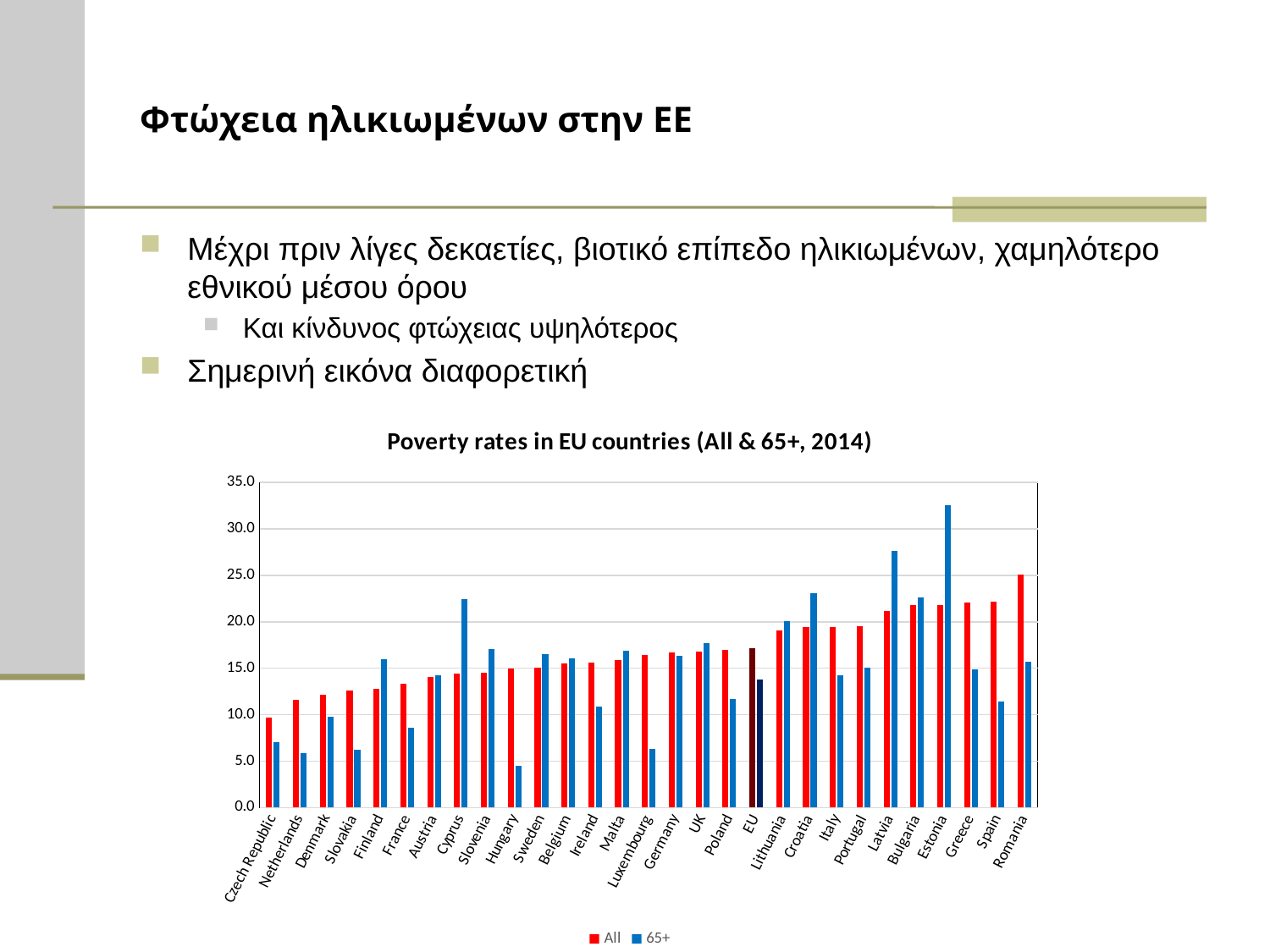
Which country has the lowest 65+ poverty rate? Hungary How many series does the legend list? 2 Is the 65+ value for Hungary greater or less than 5.0? less Do the values of the All series rise or fall from left to right along the x axis? rise Which country has the highest poverty rate for the All series? Romania Which country has the lowest poverty rate for the All series? Czech Republic How many countries/categories are shown on the x axis? 29 For Spain, which is larger: the All value or the 65+ value? All Is the 65+ value for Estonia greater or less than 30.0? greater What is the title of the chart? Poverty rates in EU countries (All & 65+, 2014) What type of chart is shown on the slide? bar chart Which country has the highest 65+ poverty rate? Estonia